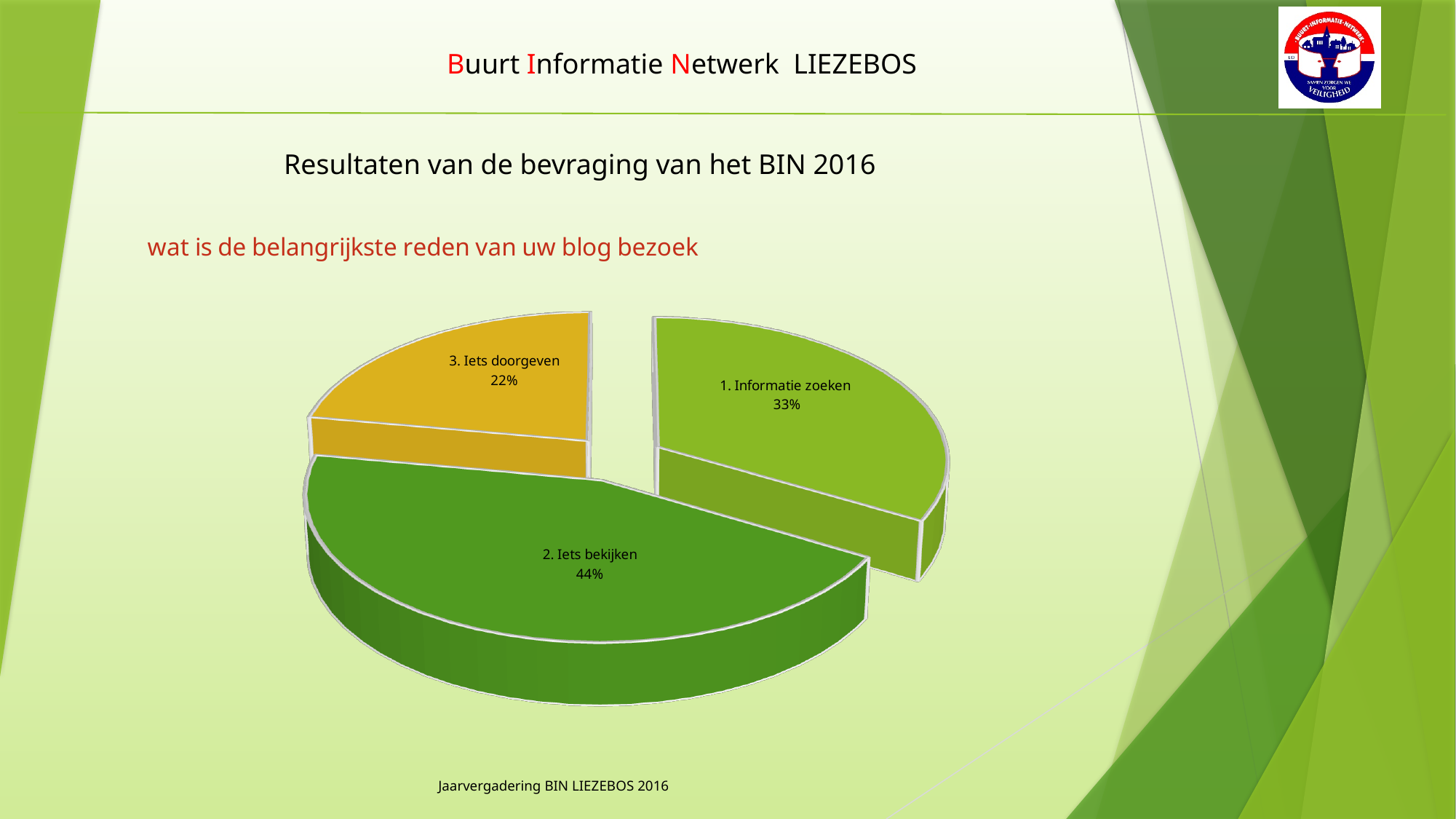
What share of the pie does "1. Informatie zoeken" represent? 33% Which is larger, the slice for "1. Informatie zoeken" or the slice for "3. Iets doorgeven"? 1. Informatie zoeken What share of the pie does "2. Iets bekijken" represent? 44% How many slices does the pie chart have? 3 Which category has the smallest slice of the pie? 3. Iets doorgeven What is the difference in percentage points between "1. Informatie zoeken" and "3. Iets doorgeven"? 11 Which category has the largest slice of the pie? 2. Iets bekijken What share of the pie does "3. Iets doorgeven" represent? 22% What is the difference in percentage points between "2. Iets bekijken" and "1. Informatie zoeken"? 11 What kind of chart is shown on the slide? Pie chart What colour is the slice for "3. Iets doorgeven"? Yellow/gold What question does the chart on the slide answer, according to the red heading? wat is de belangrijkste reden van uw blog bezoek